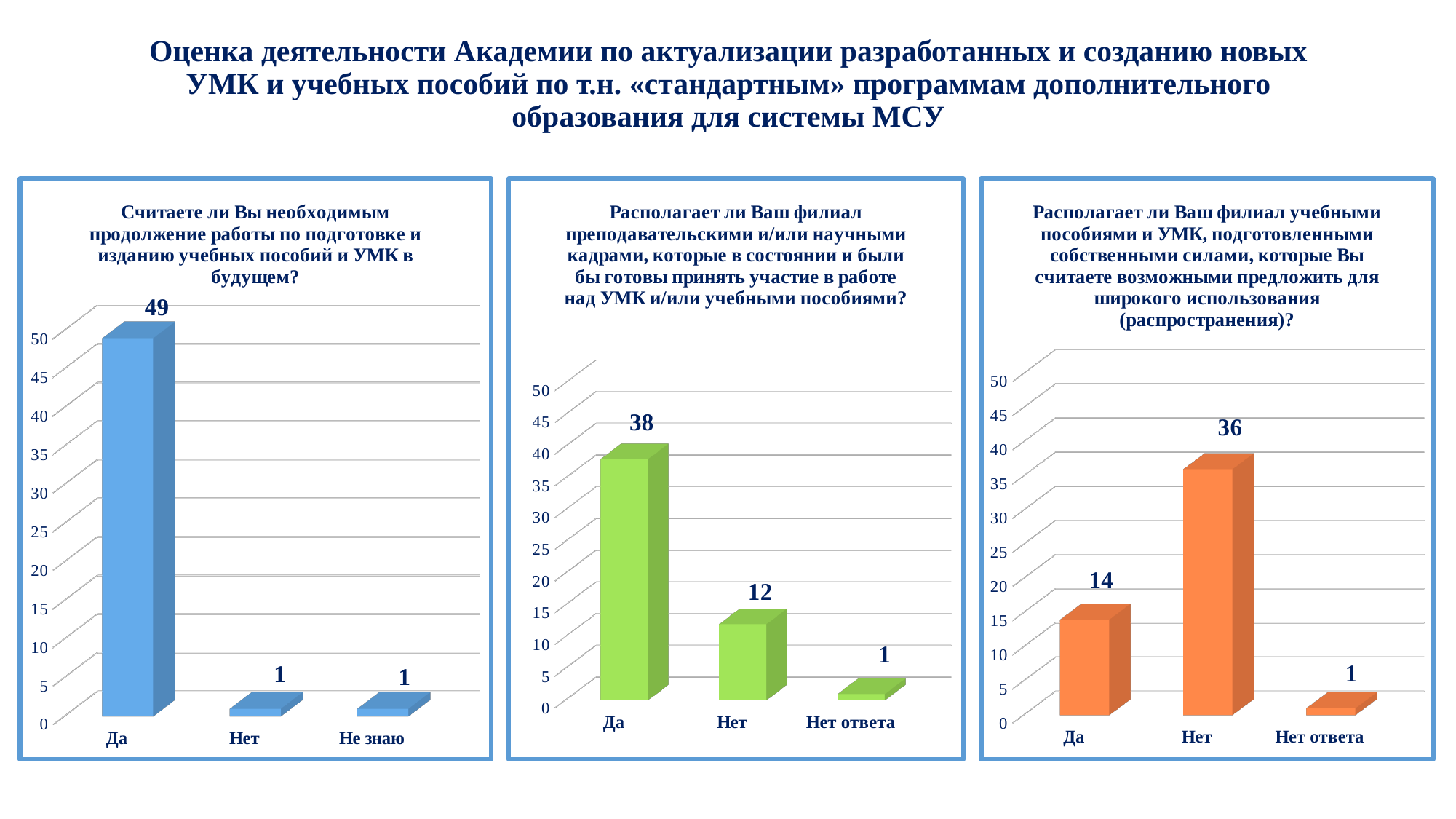
In the left chart, how many categories are shown on the x axis? 3 In the right chart, which is larger, the value for "Да" or the value for "Нет"? Нет In the middle chart, which category has the lowest value? Нет ответа In the middle chart, what is the value for "Нет"? 12 In the right chart, what is the value for "Нет"? 36 What kind of chart is the right chart? Bar chart In the middle chart, what is the difference between the values for "Да" and "Нет"? 26 In the left chart, what is the value for "Не знаю"? 1 In the left chart, which category has the highest value? Да In the right chart, what is the difference between the values for "Нет" and "Да"? 22 In the middle chart, is the value for "Да" greater or less than 35? greater In the left chart, what is the value for "Да"? 49